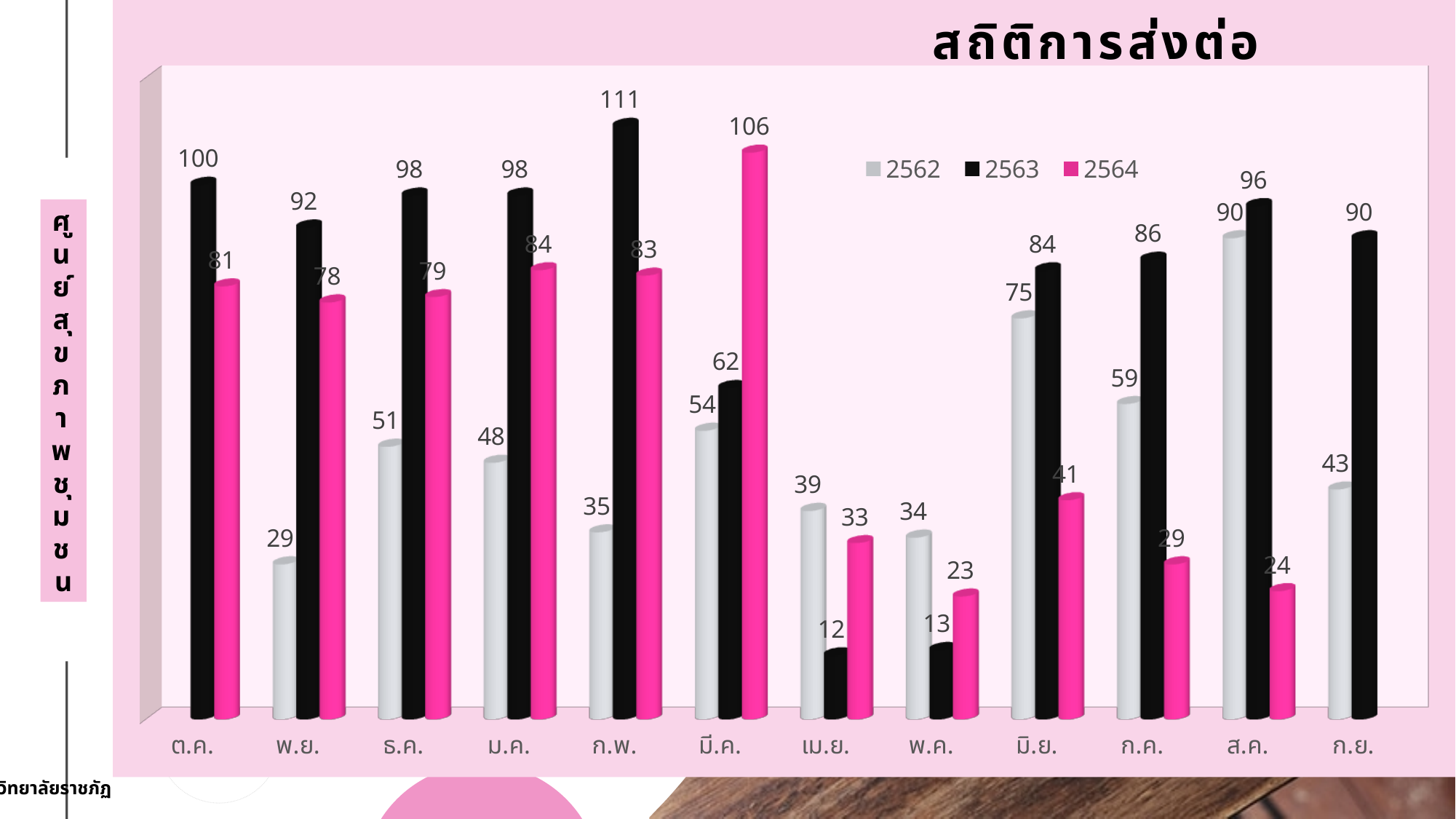
What kind of chart is shown? bar chart In which month is the 2563 value highest? ก.พ. Which is larger in มี.ค., the 2563 value or the 2564 value? 2564 What is the title of the chart? สถิติการส่งต่อ How many series does the legend list? 3 How many months are shown on the x axis? 12 What is the value for 2564 in มี.ค.? 106 What is the value for 2562 in ส.ค.? 90 What is the difference between the 2563 and 2562 values in มิ.ย.? 9 What is the value for 2563 in ก.พ.? 111 In which month is the 2564 value lowest? พ.ค. What is the value for 2563 in เม.ย.? 12